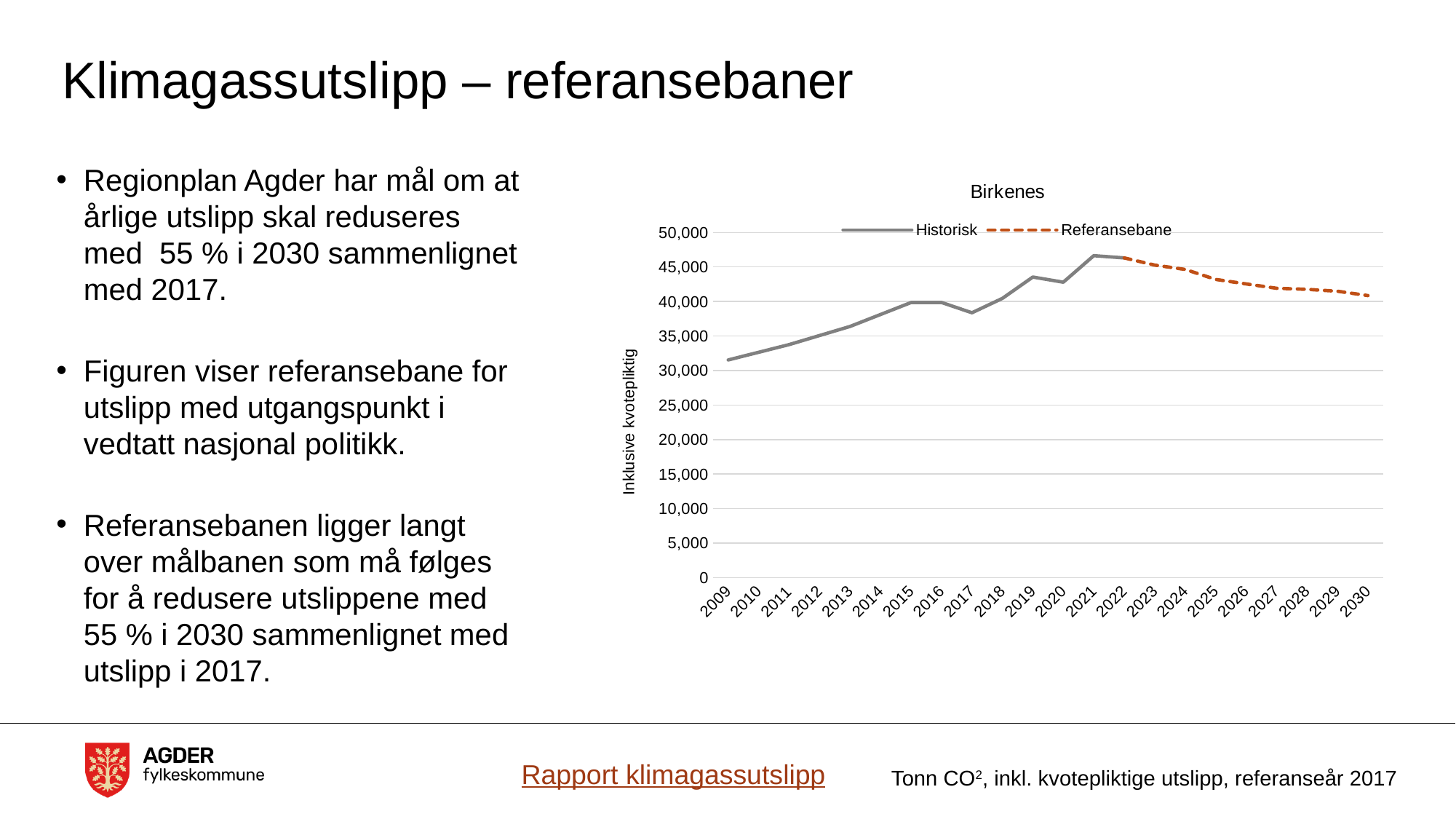
What is the title of the chart? Birkenes How many years are shown on the x axis of the chart? 22 Does the Referansebane series rise or fall from 2022 to 2030? Fall What are the two series named in the chart legend? Historisk and Referansebane In which year does the Historisk series have its lowest value? 2009 What kind of chart is shown on the slide? Line chart Is the Historisk value for 2021 greater or less than 45,000? greater In which year does the Historisk series reach its highest value? 2021 Is the Referansebane value for 2030 greater or less than 45,000? less How many series does the chart legend list? 2 Which is larger, the Historisk value for 2021 or the Referansebane value for 2030? Historisk value for 2021 Is the Historisk value for 2009 greater or less than 35,000? less